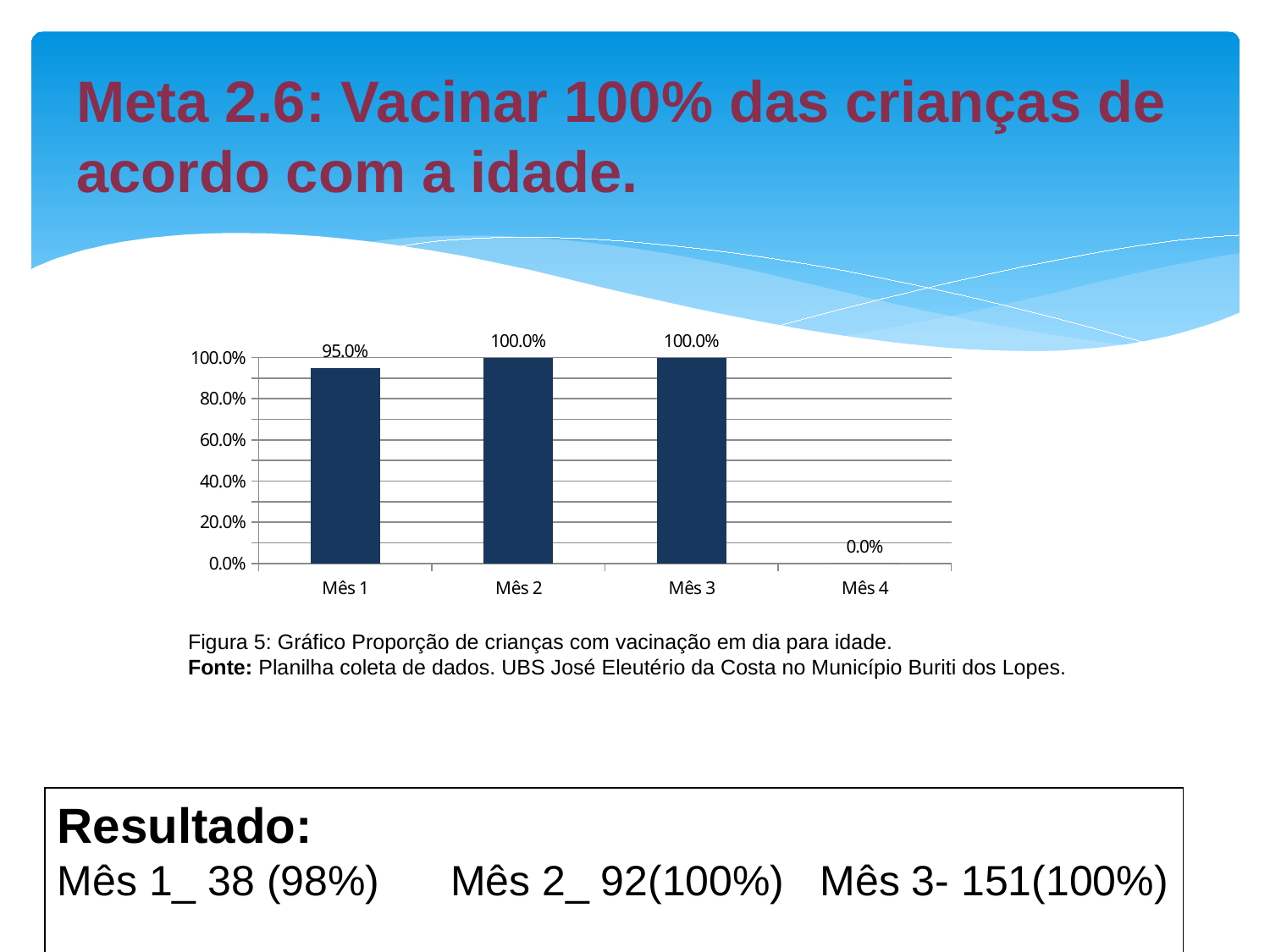
Does the value rise or fall from Mês 1 to Mês 2? rise What is the value for Mês 4? 0.0% What kind of chart is shown on the slide? bar chart What is the value for Mês 3? 100.0% What is the difference between the values for Mês 2 and Mês 1? 5.0% Which is larger, the value for Mês 1 or the value for Mês 2? Mês 2 What figure number is given in the caption below the chart? Figura 5 What is the value for Mês 1? 95.0% Which month has the lowest value? Mês 4 Is the value for Mês 1 greater or less than 80.0%? greater How many months are shown on the x axis? 4 What is the value for Mês 2? 100.0%